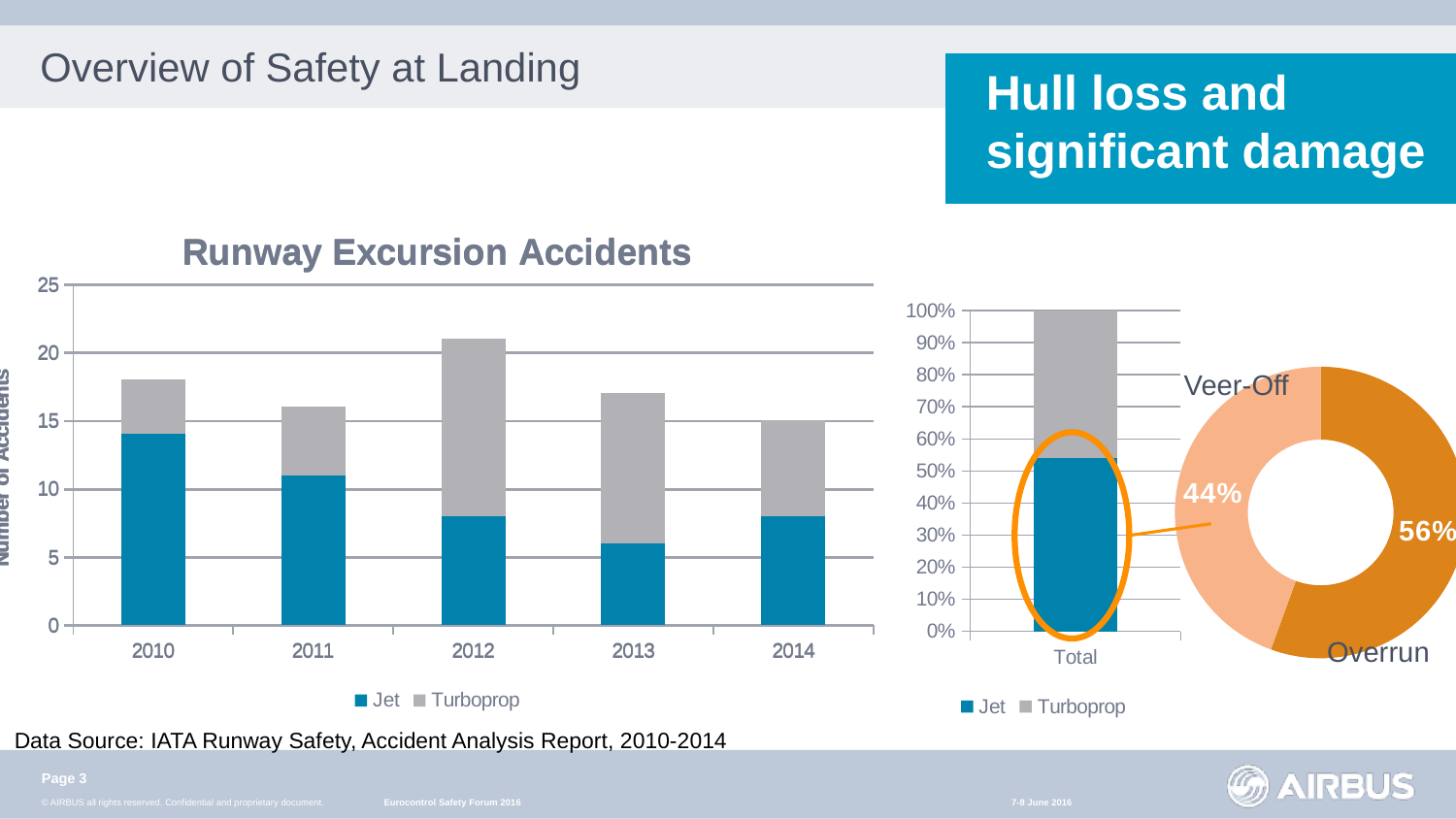
In the Runway Excursion Accidents chart, is the total number of accidents for 2012 greater or less than 20? greater What kind of chart is the Runway Excursion Accidents chart? bar chart In the 100% stacked bar chart labelled Total, is the Jet share greater or less than 50%? greater In the Runway Excursion Accidents chart, which year has the highest total number of accidents? 2012 In the donut chart on the right, what share of accidents is Veer-Off? 44% In the Runway Excursion Accidents chart, which year has more Jet accidents, 2010 or 2011? 2010 In the donut chart on the right, what share of accidents is Overrun? 56% How many years are shown on the x axis of the Runway Excursion Accidents chart? 5 In the Runway Excursion Accidents chart, which year has the lowest number of Jet accidents? 2013 How many series does the legend of the Runway Excursion Accidents chart list? 2 In the Runway Excursion Accidents chart, is the number of Jet accidents in 2013 greater or less than 10? less In the donut chart on the right, what is the difference between the Overrun and Veer-Off shares? 12%